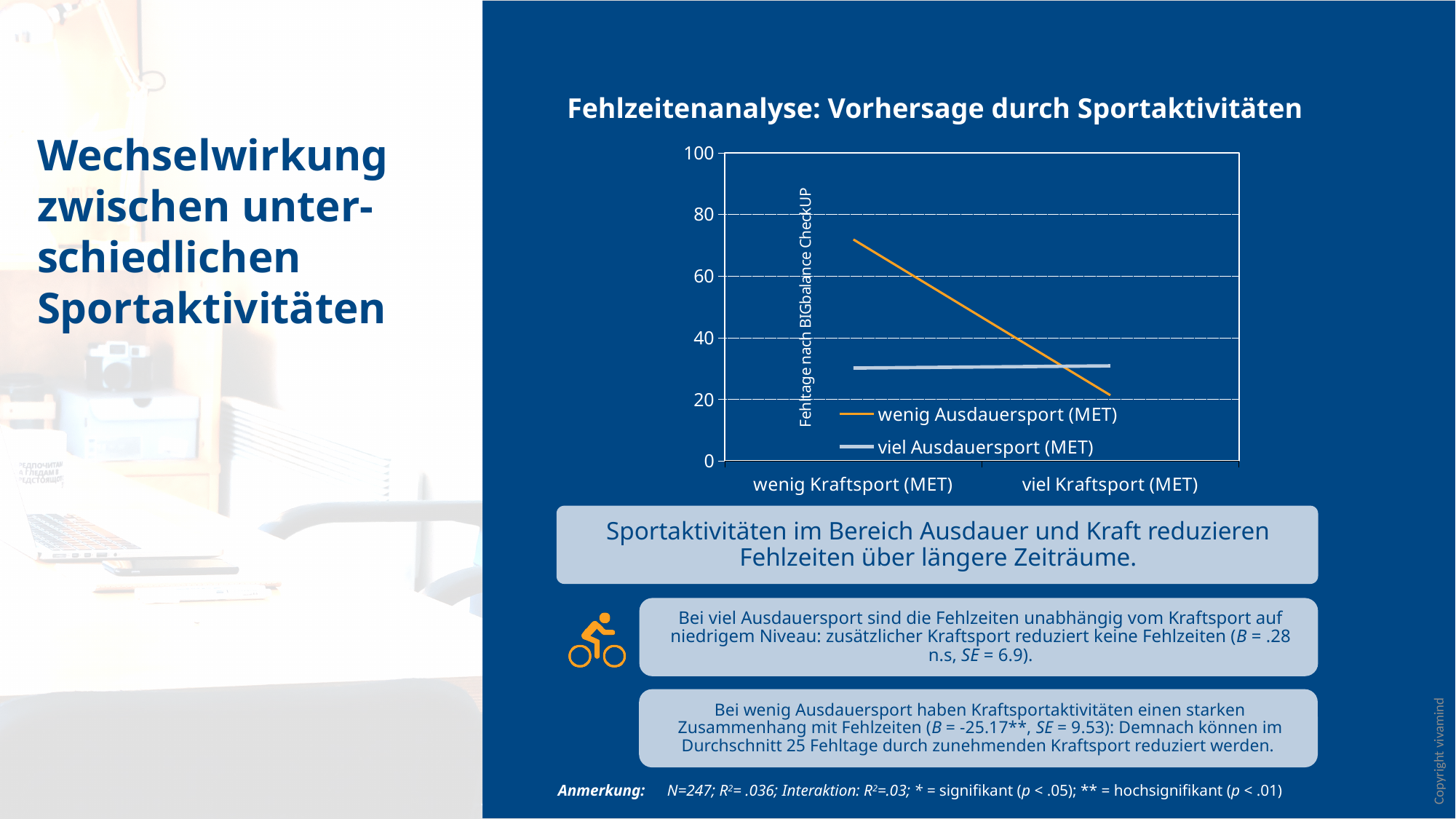
Is the value for 'wenig Ausdauersport (MET)' at 'viel Kraftsport (MET)' greater or less than 40? less At 'wenig Kraftsport (MET)', which series has the higher value: 'wenig Ausdauersport (MET)' or 'viel Ausdauersport (MET)'? wenig Ausdauersport (MET) At 'viel Kraftsport (MET)', which series has the higher value: 'wenig Ausdauersport (MET)' or 'viel Ausdauersport (MET)'? viel Ausdauersport (MET) Does the line for 'wenig Ausdauersport (MET)' rise or fall from 'wenig Kraftsport (MET)' to 'viel Kraftsport (MET)'? fall How many series does the chart legend list? 2 What is the label of the y axis of the chart? Fehltage nach BIGbalance CheckUP Is the value for 'viel Ausdauersport (MET)' at 'viel Kraftsport (MET)' greater or less than 20? greater Is the value for 'wenig Ausdauersport (MET)' at 'wenig Kraftsport (MET)' greater or less than 60? greater How many categories are shown on the x axis of the chart? 2 What kind of chart is shown on the slide? line chart What is the title of the chart? Fehlzeitenanalyse: Vorhersage durch Sportaktivitäten